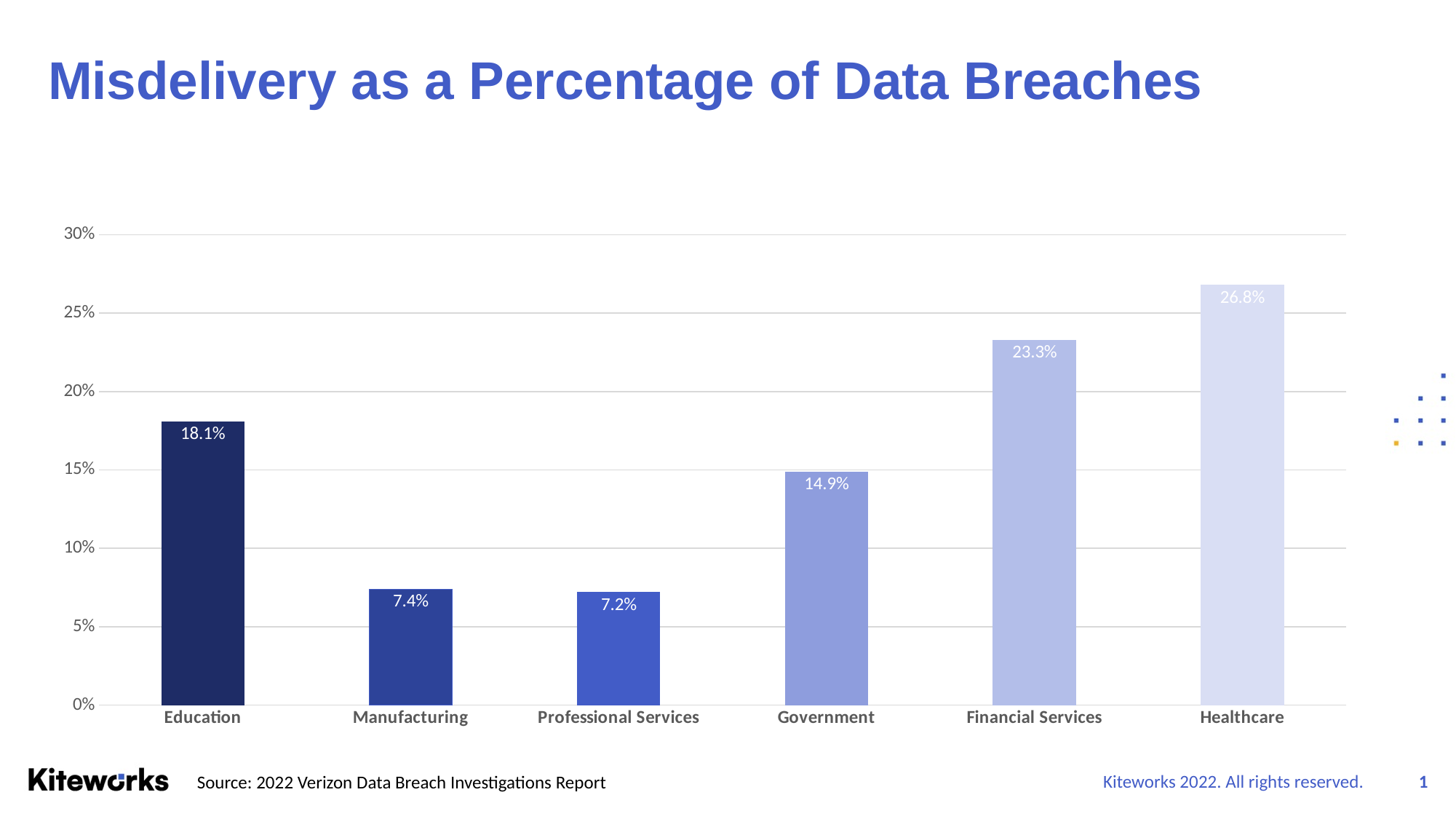
Which category has the highest value? Healthcare Which is larger, the value for Education or the value for Government? Education How many categories are shown on the x axis? 6 What is the title of the chart? Misdelivery as a Percentage of Data Breaches What is the difference between the values for Manufacturing and Professional Services? 0.2% What is the value for Government? 14.9% What kind of chart is shown on the slide? bar chart Which category has the lowest value? Professional Services What is the difference between the values for Healthcare and Financial Services? 3.5% What is the value for Healthcare? 26.8% What is the value for Education? 18.1% Is the value for Financial Services greater or less than 20%? greater